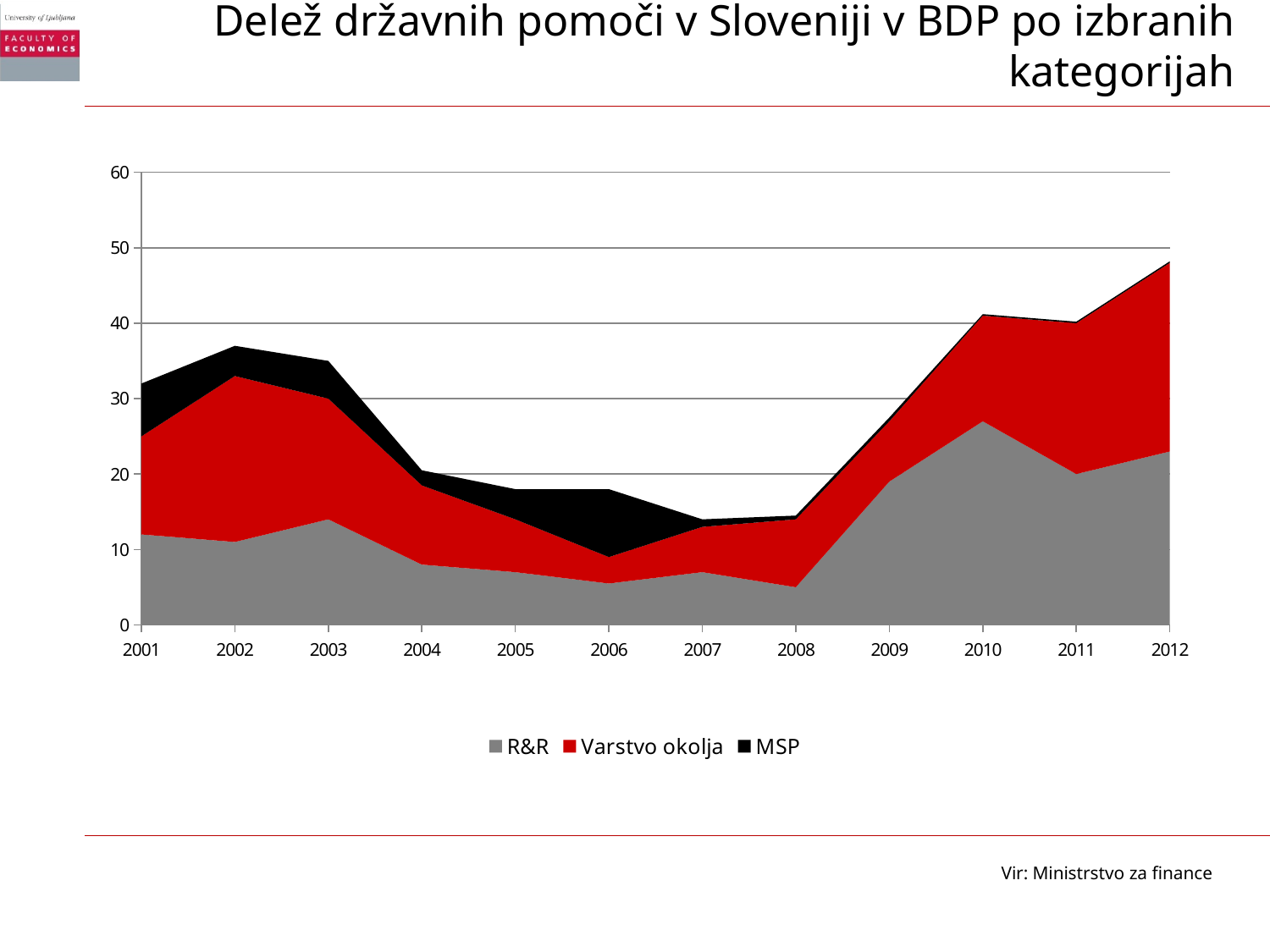
Is the value for R&R in 2008 greater or less than 10? less In which year is the value for R&R highest? 2010 How many series does the legend list? 3 What kind of chart is shown on the slide? stacked area chart What is the title of the chart? Delež državnih pomoči v Sloveniji v BDP po izbranih kategorijah Is the value for R&R in 2010 greater or less than 20? greater In which year is the stacked total highest? 2012 Is the stacked total in 2012 greater or less than 40? greater How many years are shown along the x axis? 12 Does the stacked total rise or fall from 2002 to 2007? fall Which series is drawn in black? MSP